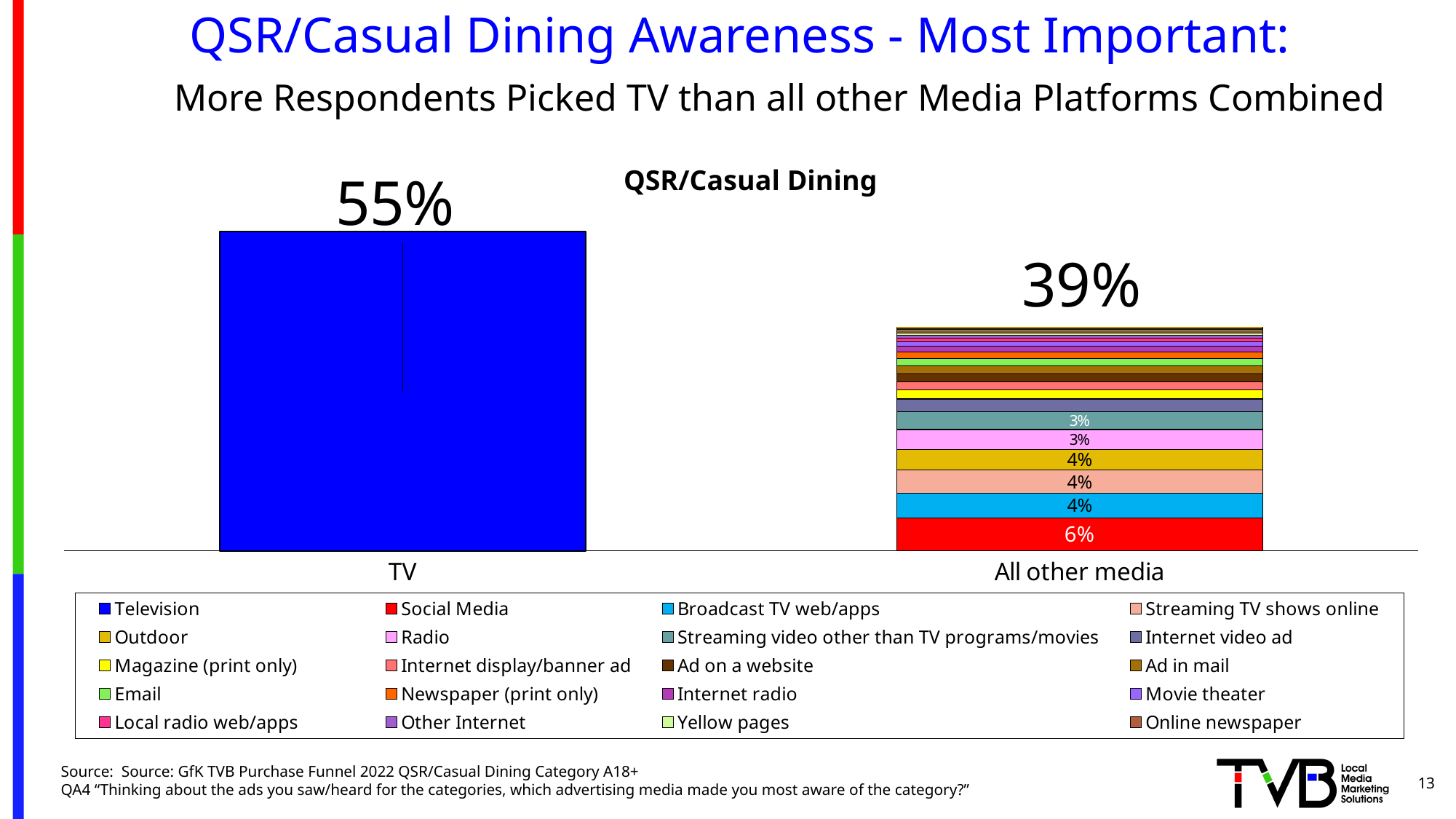
Which bar is taller, TV or All other media? TV What is the value shown for TV? 55% What kind of chart is shown on the slide? Stacked bar chart What is the value of the Social Media segment in the All other media bar? 6% What is the value of the Radio segment? 3% Which segment of the All other media bar has the largest value? Social Media What is the difference between the TV value and the All other media total? 16 percentage points What is the value of the Broadcast TV web/apps segment? 4% How many series does the legend list? 20 What is the total value shown above the All other media bar? 39% How many categories are shown on the x axis? 2 What is the title of the chart? QSR/Casual Dining